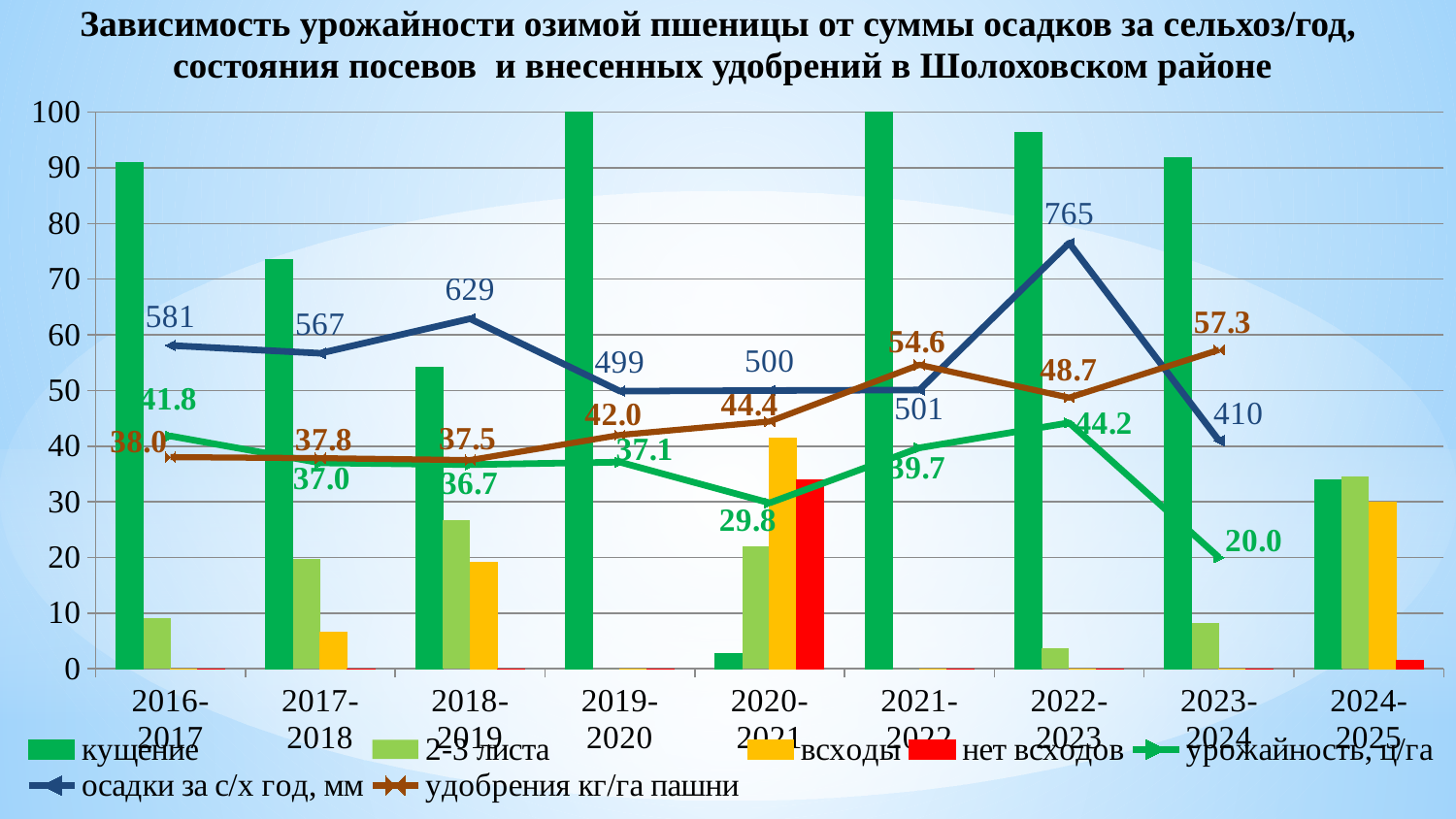
Is the кущение bar for 2016-2017 greater or less than 80? greater In which year is осадки за с/х год, мм the highest? 2022-2023 What is the value of осадки за с/х год, мм for 2022-2023? 765 What kind of chart is this? Combined bar and line chart How many year categories are shown on the x axis? 9 Which year has the larger удобрения кг/га пашни value, 2021-2022 or 2022-2023? 2021-2022 What is the difference between осадки за с/х год, мм in 2022-2023 and in 2023-2024? 355 In which year is урожайность, ц/га the lowest? 2023-2024 How many series does the legend list? 7 What is the удобрения кг/га пашни value for 2023-2024? 57.3 What is the урожайность, ц/га value for 2020-2021? 29.8 Is the кущение bar for 2020-2021 greater or less than 10? less